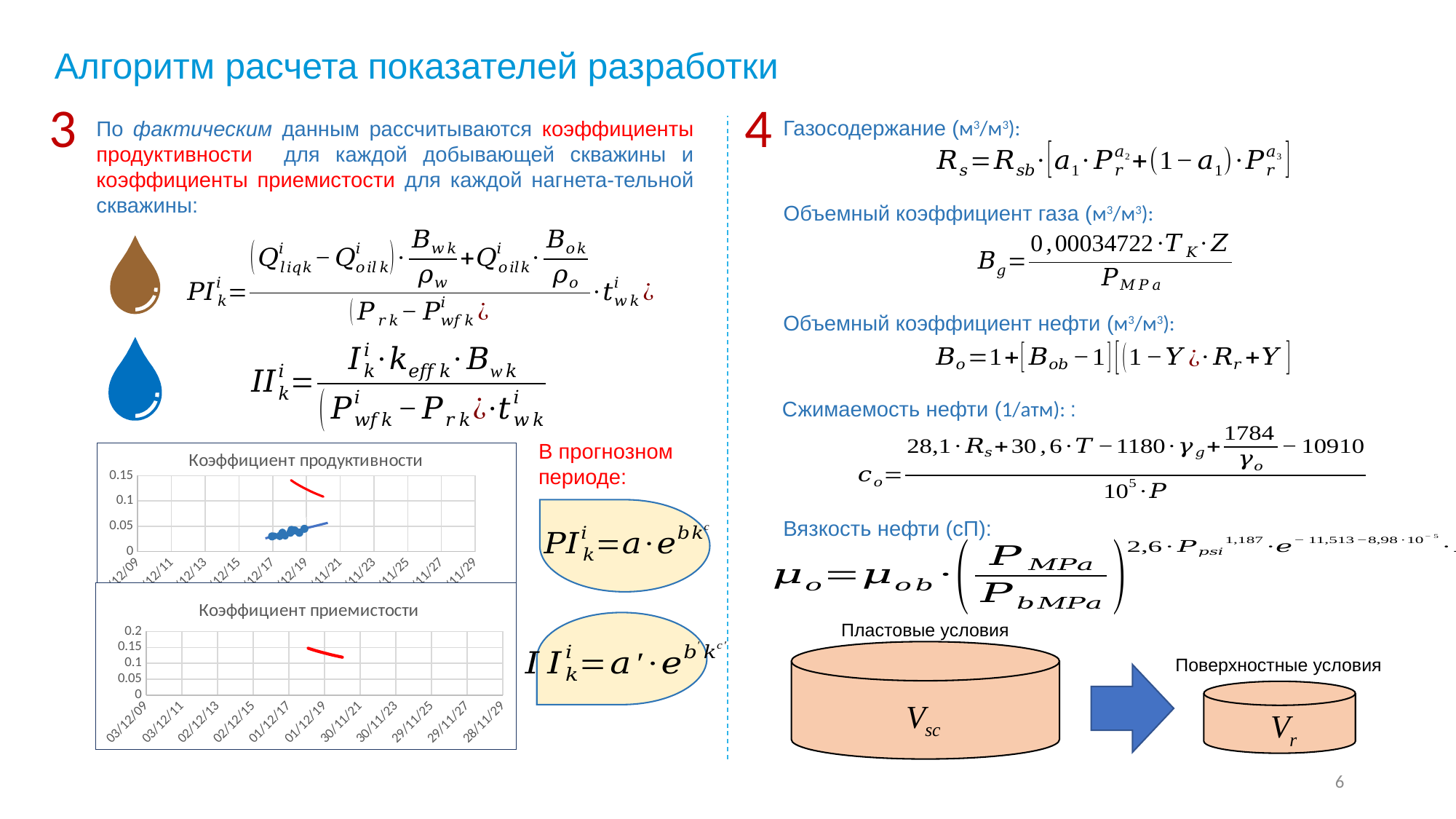
In the chart titled 'Коэффициент приемистости', does the red line rise or fall along the x axis? fall What is the title of the upper chart on the slide? Коэффициент продуктивности In the chart titled 'Коэффициент приемистости', what kind of chart is shown? line chart In the chart titled 'Коэффициент продуктивности', is the highest value of the red line greater or less than 0.1? greater What is the title of the lower chart on the slide? Коэффициент приемистости In the chart titled 'Коэффициент продуктивности', are the values of the red line greater or less than 0.05? greater In the chart titled 'Коэффициент приемистости', are the values of the red line greater or less than 0.2? less In the chart titled 'Коэффициент продуктивности', does the red line rise or fall along the x axis? fall In the chart titled 'Коэффициент приемистости', how many date labels are shown on the x axis? 11